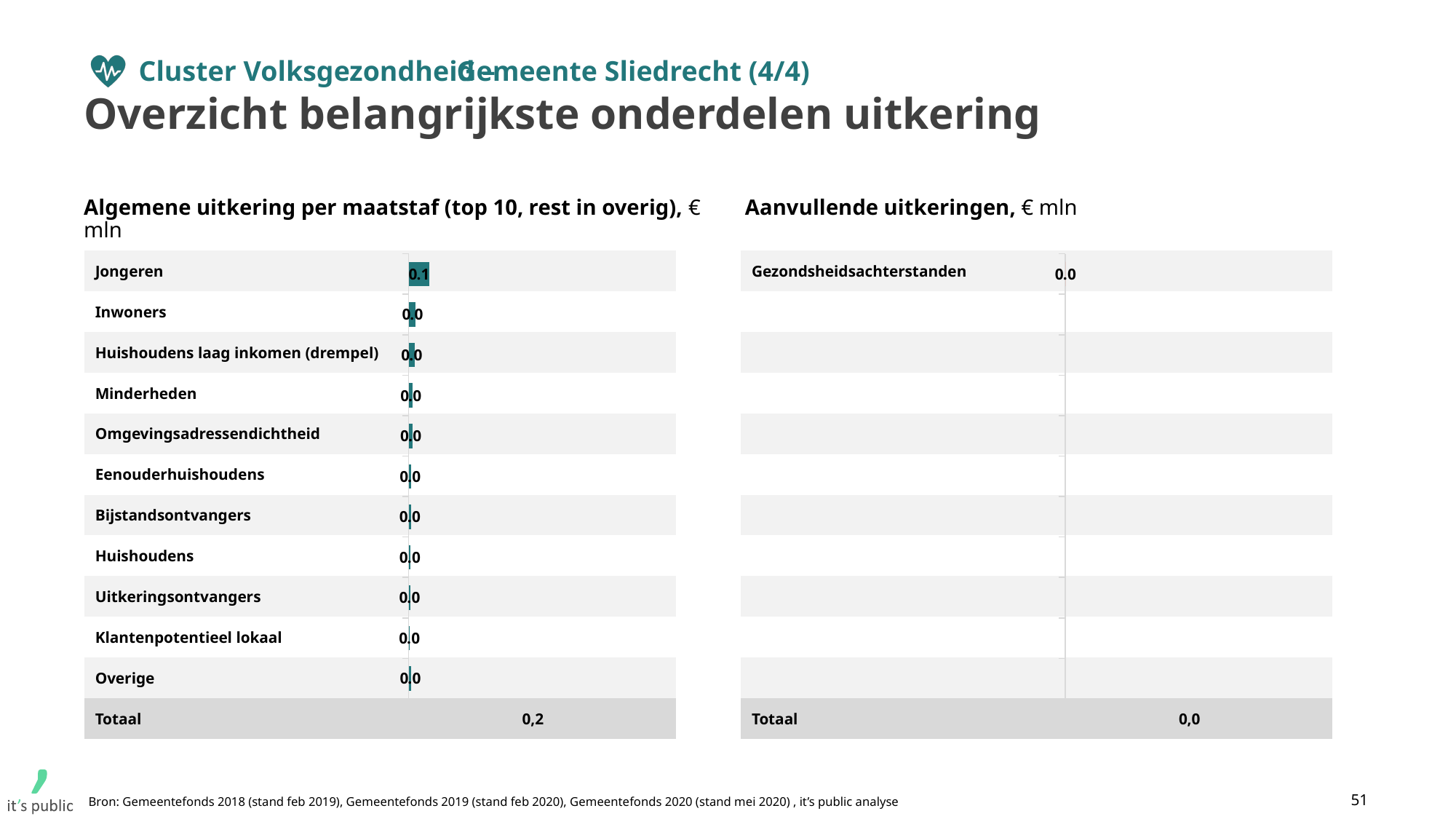
In the chart 'Aanvullende uitkeringen', how many categories are plotted (excluding the Totaal row)? 1 In the chart 'Algemene uitkering per maatstaf (top 10, rest in overig)', which category has the highest value? Jongeren In the chart 'Algemene uitkering per maatstaf (top 10, rest in overig)', what is the value for Inwoners? 0.0 In the chart 'Aanvullende uitkeringen', what is the value for Gezondsheidsachterstanden? 0.0 In the chart 'Algemene uitkering per maatstaf (top 10, rest in overig)', what is the difference between the value for Jongeren and the value for Overige? 0.1 What unit is stated in the title of the chart on the right side of the slide? € mln In the chart 'Aanvullende uitkeringen', what value is shown in the Totaal row? 0,0 In the chart 'Algemene uitkering per maatstaf (top 10, rest in overig)', which is larger: the value for Jongeren or the value for Huishoudens? Jongeren In the chart 'Algemene uitkering per maatstaf (top 10, rest in overig)', how many categories are plotted (excluding the Totaal row)? 11 What kind of chart is 'Algemene uitkering per maatstaf (top 10, rest in overig)'? Bar chart In the chart 'Algemene uitkering per maatstaf (top 10, rest in overig)', what is the value for Jongeren? 0.1 In the chart 'Algemene uitkering per maatstaf (top 10, rest in overig)', what value is shown in the Totaal row? 0,2